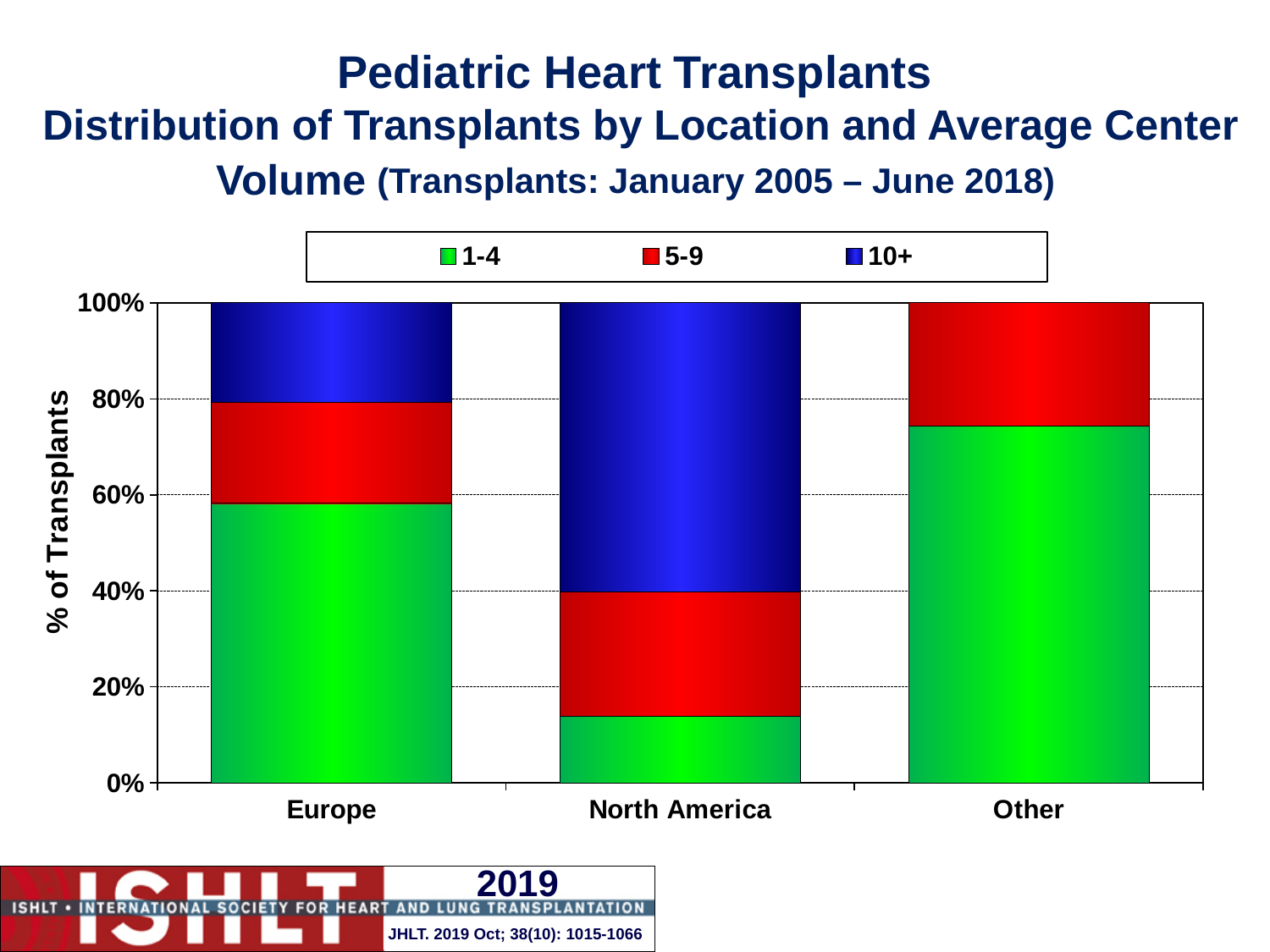
Is the 1-4 share for North America greater or less than 20%? less Which location has the largest 1-4 share? Other What is the total of the stacked bar for Europe? 100% What kind of chart is shown on the slide? Stacked bar chart How many locations are shown on the x axis? 3 Is the 10+ share larger for Europe or for North America? North America Which location has the smallest 1-4 share? North America Is the 1-4 share for Other greater or less than 60%? greater Is the 1-4 share for Europe greater or less than 40%? greater How many series does the legend list? 3 What are the three series listed in the legend? 1-4, 5-9, 10+